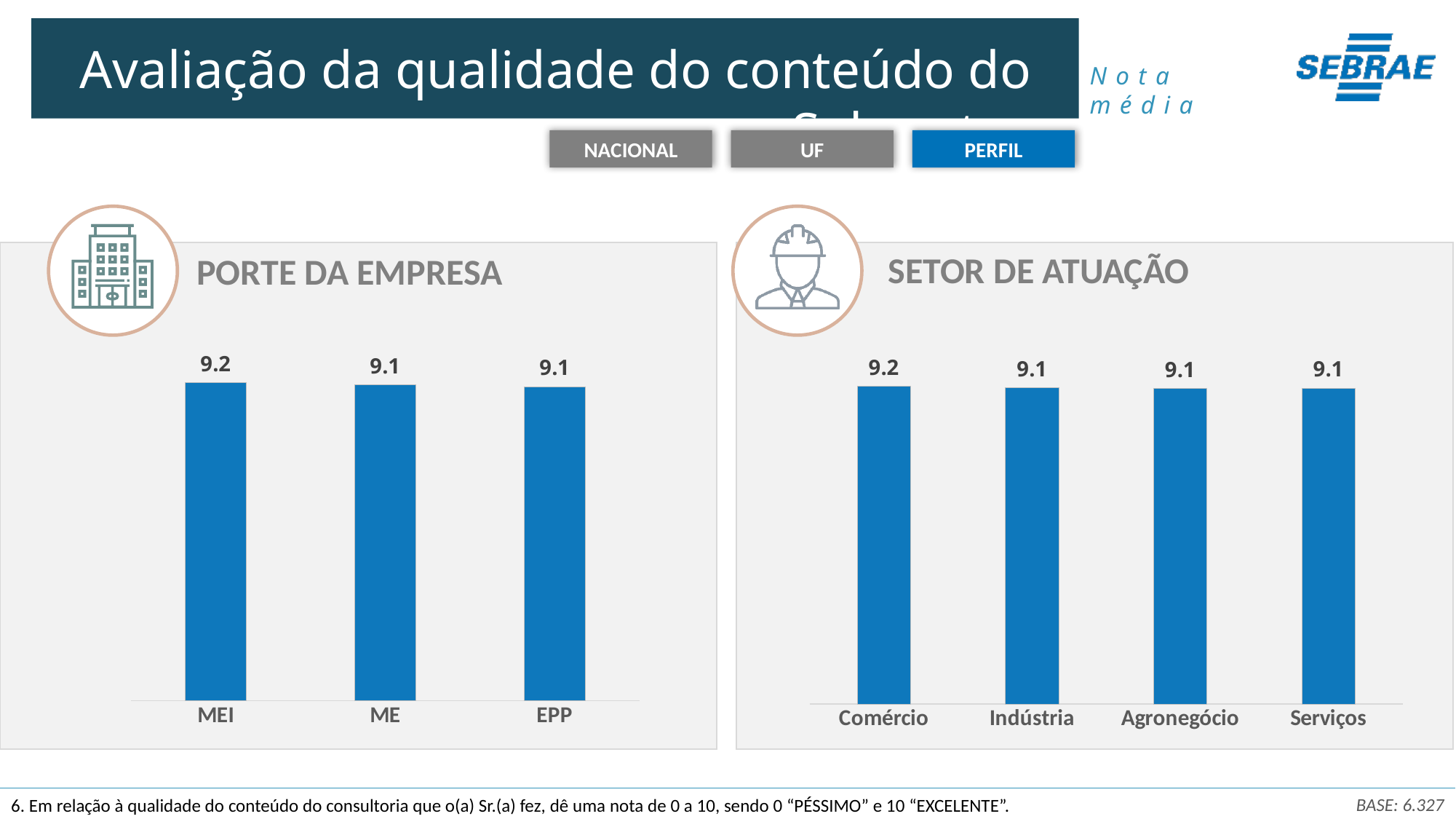
In the SETOR DE ATUAÇÃO chart, what is the value for Comércio? 9.2 In the PORTE DA EMPRESA chart, what is the difference between the values for MEI and ME? 0.1 What is the title of the chart on the left side of the slide? PORTE DA EMPRESA In the SETOR DE ATUAÇÃO chart, which category has the highest value? Comércio In the PORTE DA EMPRESA chart, how many categories are shown? 3 In the PORTE DA EMPRESA chart, what is the value for EPP? 9.1 In the SETOR DE ATUAÇÃO chart, how many categories are shown? 4 In the PORTE DA EMPRESA chart, which category has the highest value? MEI What kind of chart is the SETOR DE ATUAÇÃO chart? Bar chart In the PORTE DA EMPRESA chart, what is the value for MEI? 9.2 In the SETOR DE ATUAÇÃO chart, which is larger, the value for Comércio or the value for Serviços? Comércio In the SETOR DE ATUAÇÃO chart, what is the value for Agronegócio? 9.1